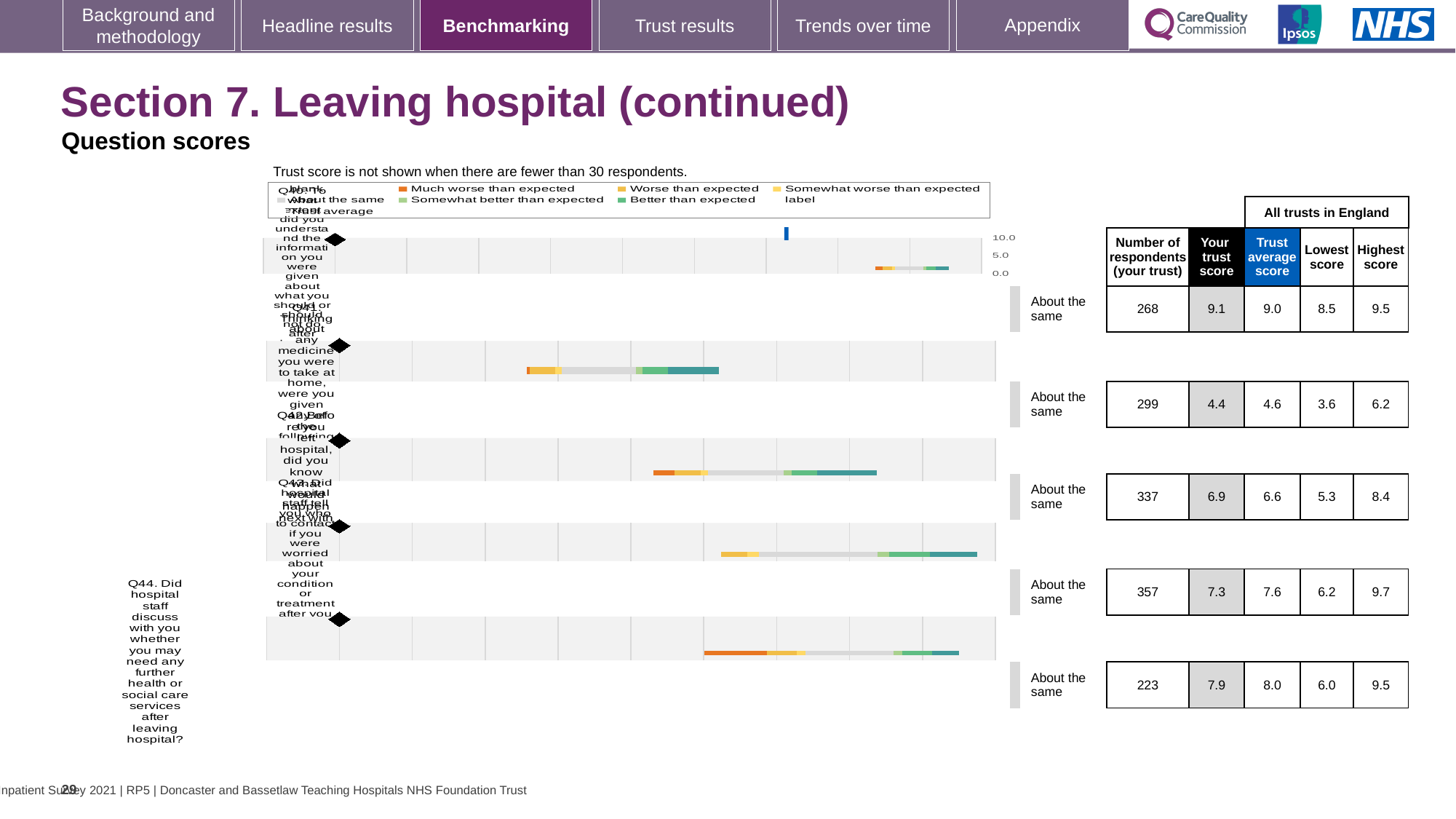
What type of chart is used to show the question scores on this slide? Bar chart How many questions (rows) are shown in the chart and table on this slide? 5 What is the lowest 'Your trust score' value shown in the table? 4.4 What is the trust average score shown in the third row of the table? 6.6 What is the 'Your trust score' for Q44 (Did hospital staff discuss with you whether you may need any further health or social care services after leaving hospital?)? 7.9 In the first row of the table, what is the difference between your trust score (9.1) and the trust average score (9.0)? 0.1 For Q44, what is the difference between the highest score (9.5) and the lowest score (6.0) across all trusts? 3.5 What is the highest score across all trusts in England for Q44? 9.5 What benchmark category label is shown next to every question on this slide? About the same Which row of the table has the largest number of respondents, and what is that number? The fourth row, 357 For Q44, which is larger: your trust score or the trust average score? Trust average score (8.0) How many respondents from your trust answered Q44? 223